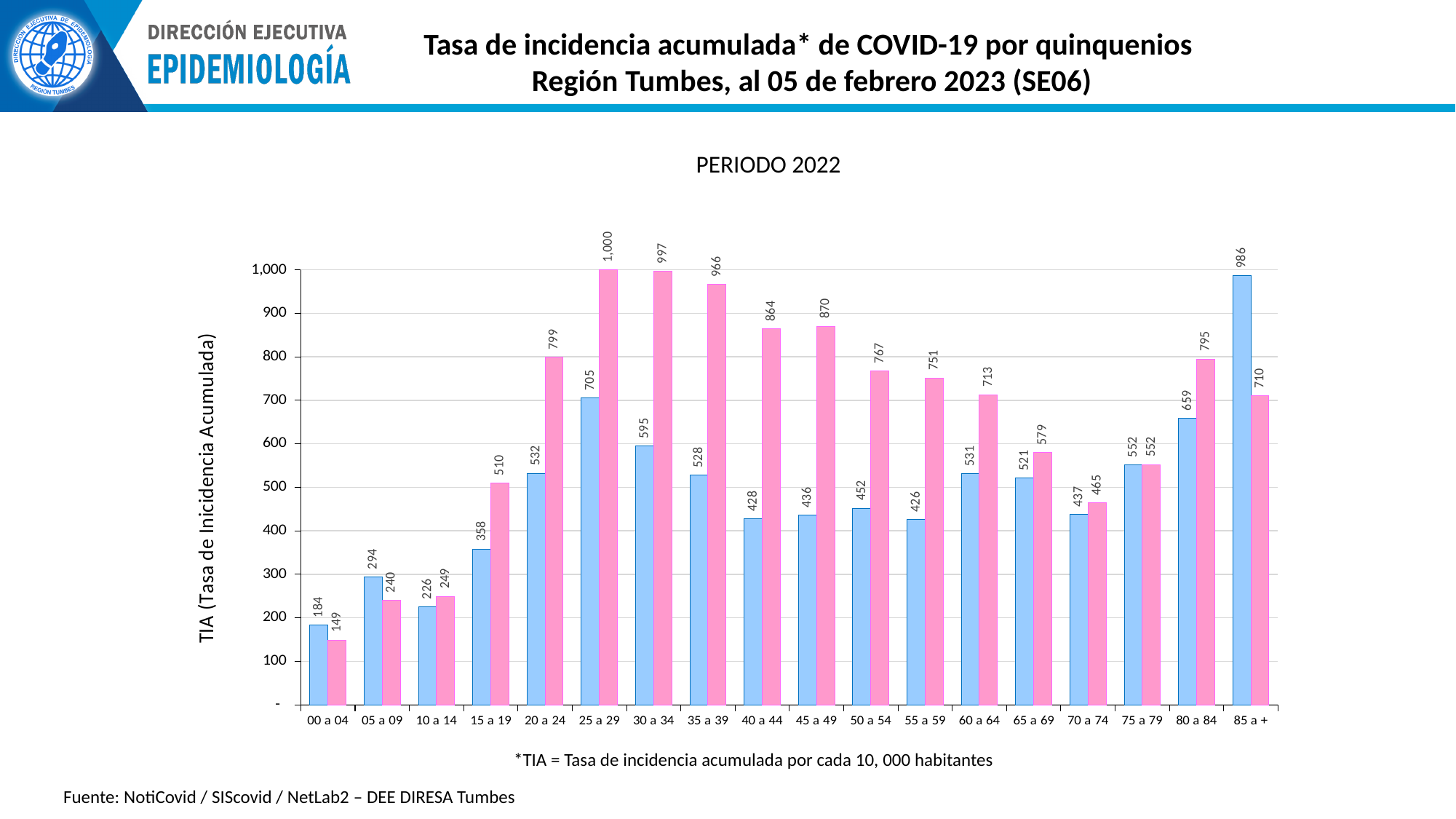
How many age groups are shown on the x axis? 18 What is the difference between the pink bar and the blue bar for the 25 a 29 age group? 295 What is the value of the pink bar for the 45 a 49 age group? 870 What kind of chart is shown on the slide? bar chart Which age group has the lowest blue bar? 00 a 04 Which age group has the highest pink bar? 25 a 29 Is the value of the pink bar for the 35 a 39 age group greater or less than 900? greater What is the difference between the blue bar and the pink bar for the 85 a + age group? 276 What is the value of the blue bar for the 25 a 29 age group? 705 Do the pink bars rise or fall from the 25 a 29 age group to the 70 a 74 age group? fall What is the value of the blue bar for the 85 a + age group? 986 For the 10 a 14 age group, which bar is larger, the blue or the pink? pink